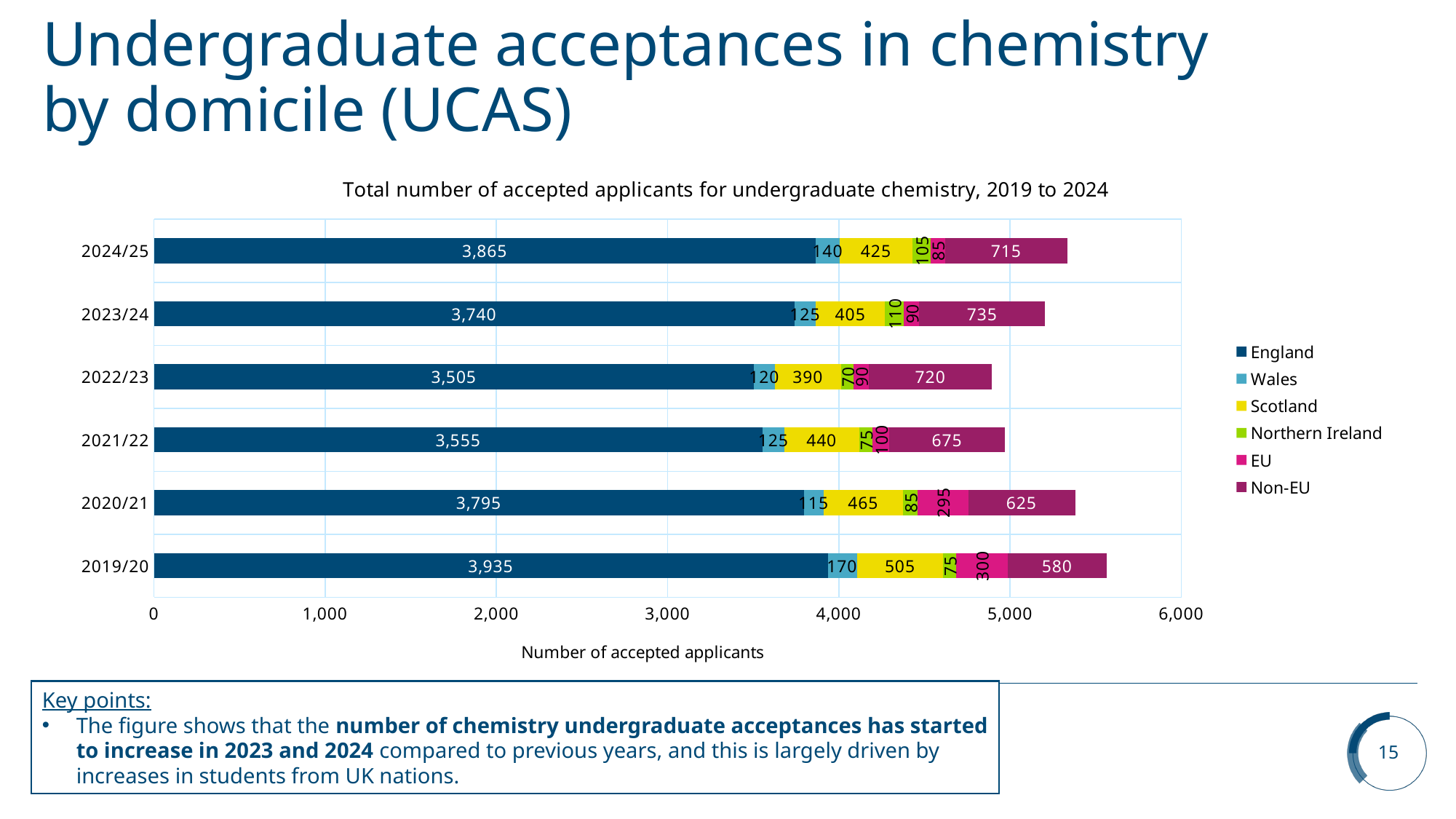
How many years are shown on the chart? 6 In which year is the England value lowest? 2022/23 What is the Non-EU value for 2019/20? 580 How many series does the legend list? 6 What is the value for England in 2024/25? 3,865 In which year is the England value highest? 2019/20 What is the total of the stacked bar for 2022/23? 4,895 What is the difference between the Non-EU values for 2023/24 and 2019/20? 155 What kind of chart is shown on the slide? Stacked bar chart Which is larger, the EU value for 2020/21 or the EU value for 2024/25? 2020/21 What is the Scotland value for 2020/21? 465 What is the label on the horizontal axis? Number of accepted applicants